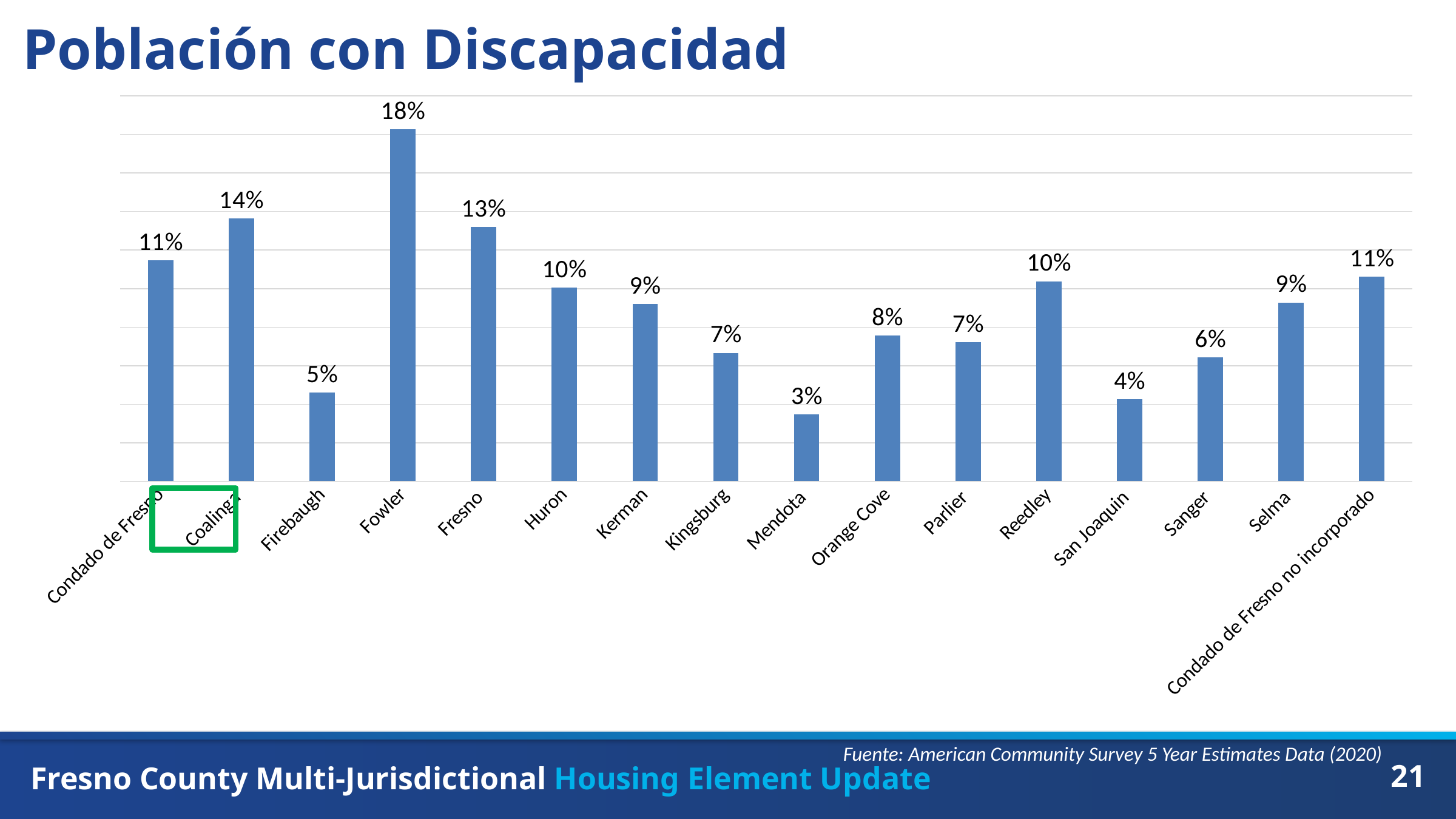
Which has a larger value, San Joaquin or Sanger? Sanger Which has a larger value, Huron or Kingsburg? Huron How many categories are shown in the chart? 16 What is the difference between the values for Coalinga and Firebaugh? 9% What kind of chart is shown on the slide? Bar chart What is the value for Coalinga? 14% What is the value for Mendota? 3% Which category has the lowest value? Mendota What is the value for Fowler? 18% What is the difference between the values for Fowler and Fresno? 5% What is the value for Condado de Fresno no incorporado? 11% Which category has the highest value? Fowler